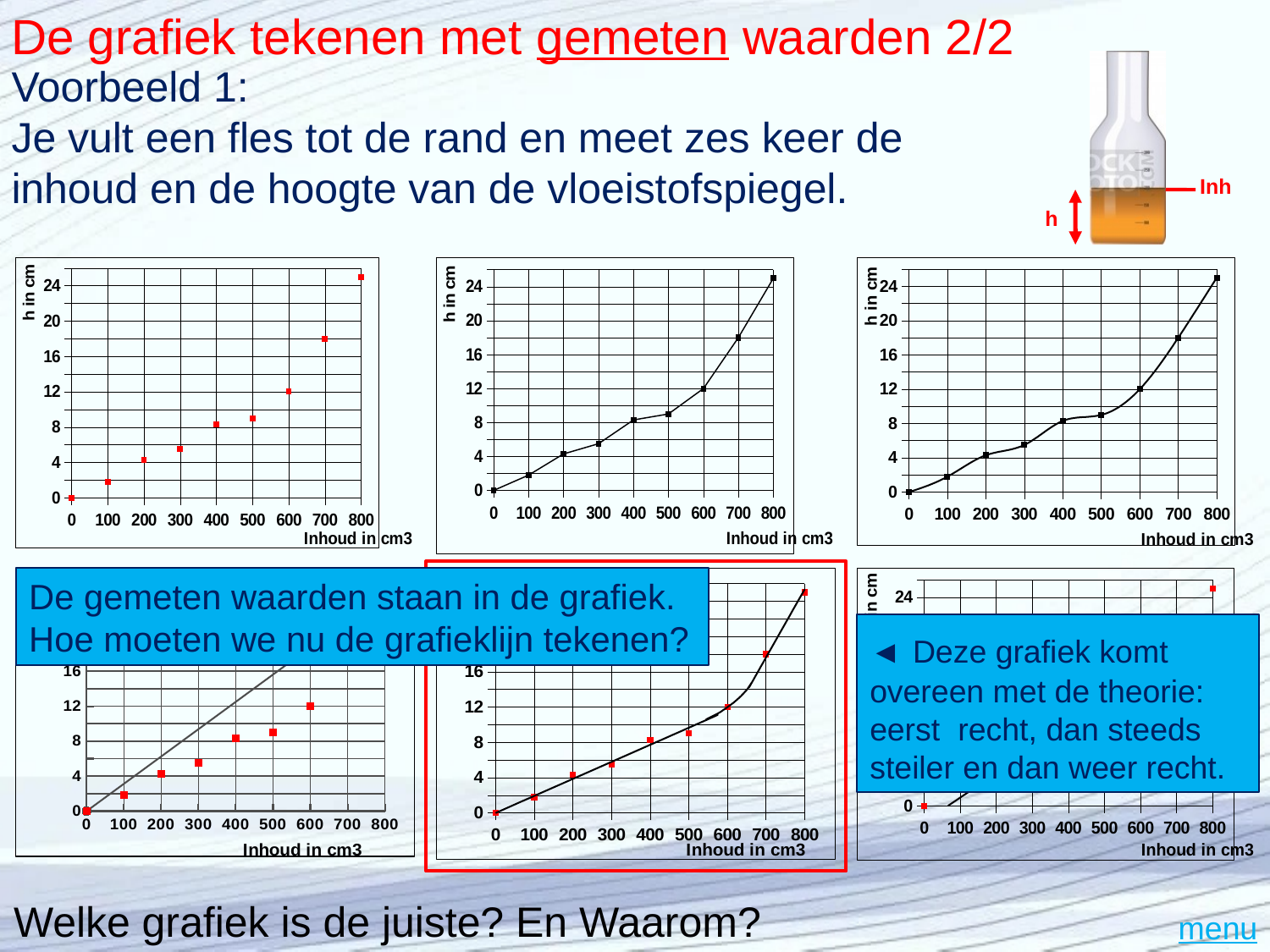
In the top-right chart, does h rise or fall as Inhoud increases from 0 to 800 cm3? rise In the top-right chart, is the value of h at 800 cm3 greater or less than 24? greater In the top-right chart, at which Inhoud value is h the highest? 800 In the top-left chart, is the value of h at 100 cm3 greater or less than 4? less In the top-left chart, what is the label of the vertical axis? h in cm How many data points are plotted in the top-left chart? 9 In the top-right chart, is the value of h at 700 cm3 greater or less than 16? greater In the top-left chart, what is the label of the horizontal axis? Inhoud in cm3 In the top-middle chart, what is the value of h at an Inhoud of 600 cm3? 12 In the top-middle chart, at which Inhoud value is h the lowest? 0 In the top-middle chart, what is the value of h at an Inhoud of 0 cm3? 0